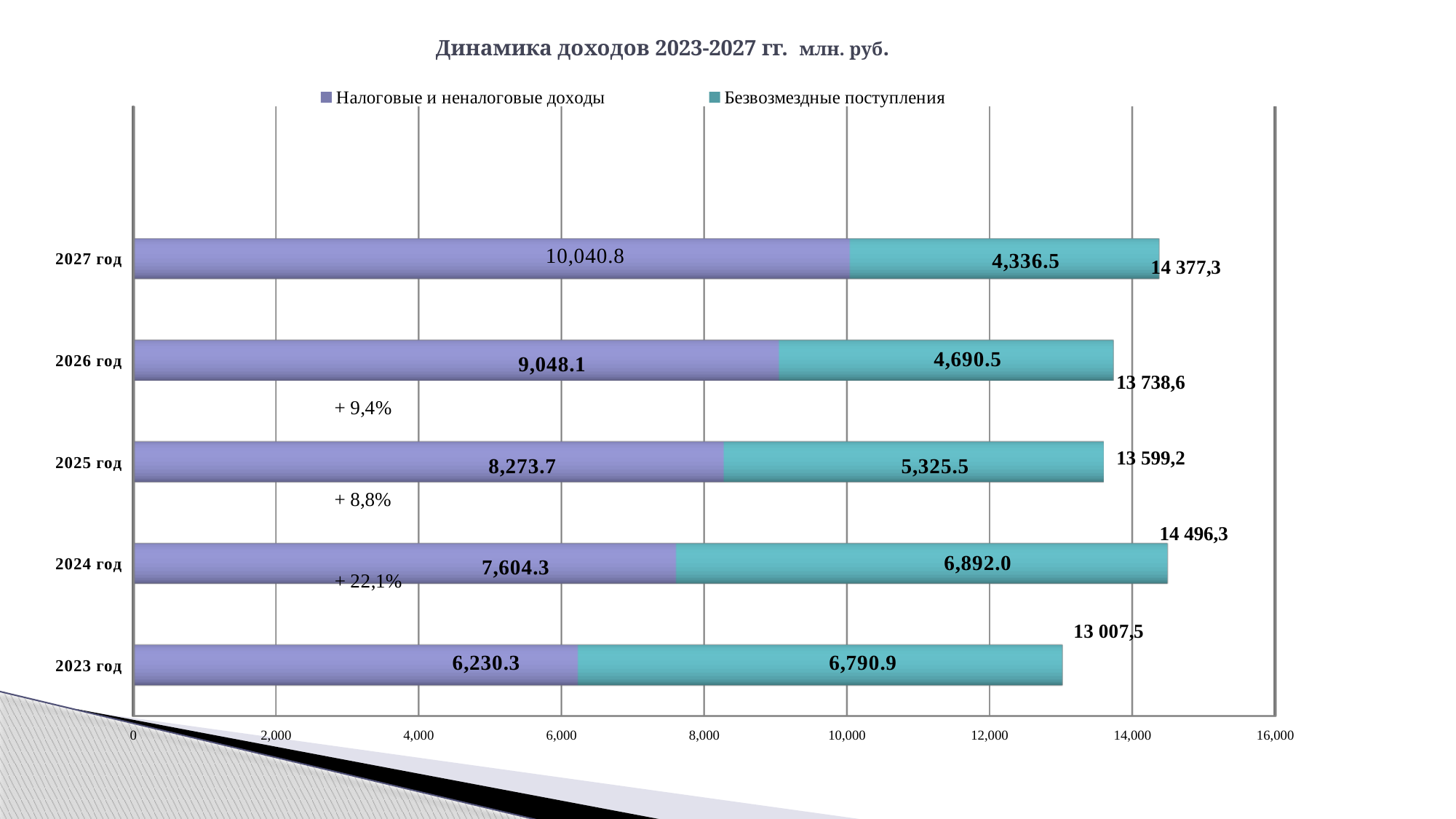
What kind of chart is shown on the slide? Stacked bar chart What is the value of Налоговые и неналоговые доходы for 2023 год? 6,230.3 Which is larger for 2023 год: Налоговые и неналоговые доходы or Безвозмездные поступления? Безвозмездные поступления What is the value of Налоговые и неналоговые доходы for 2027 год? 10,040.8 Which year has the lowest value of Безвозмездные поступления? 2027 год How many years are shown on the chart? 5 Which year has the highest value of Налоговые и неналоговые доходы? 2027 год How many series does the legend list? 2 Do the values of Налоговые и неналоговые доходы rise or fall from 2023 год to 2027 год? Rise What is the value of Безвозмездные поступления for 2024 год? 6,892.0 What is the difference between Налоговые и неналоговые доходы in 2026 год and 2025 год? 774.4 What is the total of the stacked bar for 2024 год? 14 496,3